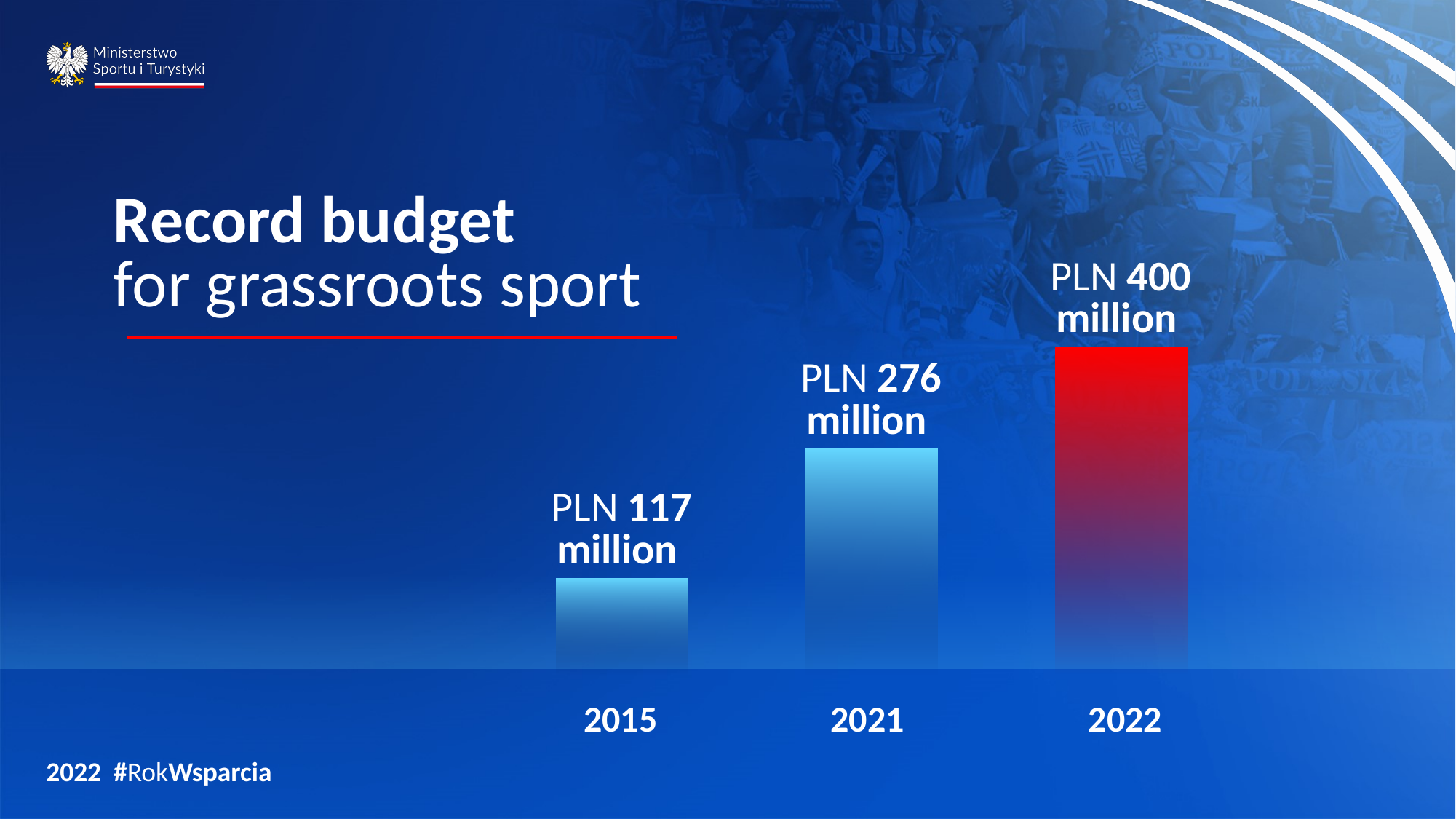
How many years are shown in the chart? 3 Which year has the lowest budget? 2015 What is the difference between the 2022 and 2021 budgets? PLN 124 million What is the budget value shown for 2021? PLN 276 million What is the budget value shown for 2015? PLN 117 million What kind of chart is shown on the slide? Bar chart What colour is the bar for 2022? Red Which year has the highest budget? 2022 What is the budget value shown for 2022? PLN 400 million Which is larger, the budget for 2015 or for 2021? 2021 Do the budget values rise or fall from 2015 to 2022? Rise What is the difference between the 2021 and 2015 budgets? PLN 159 million